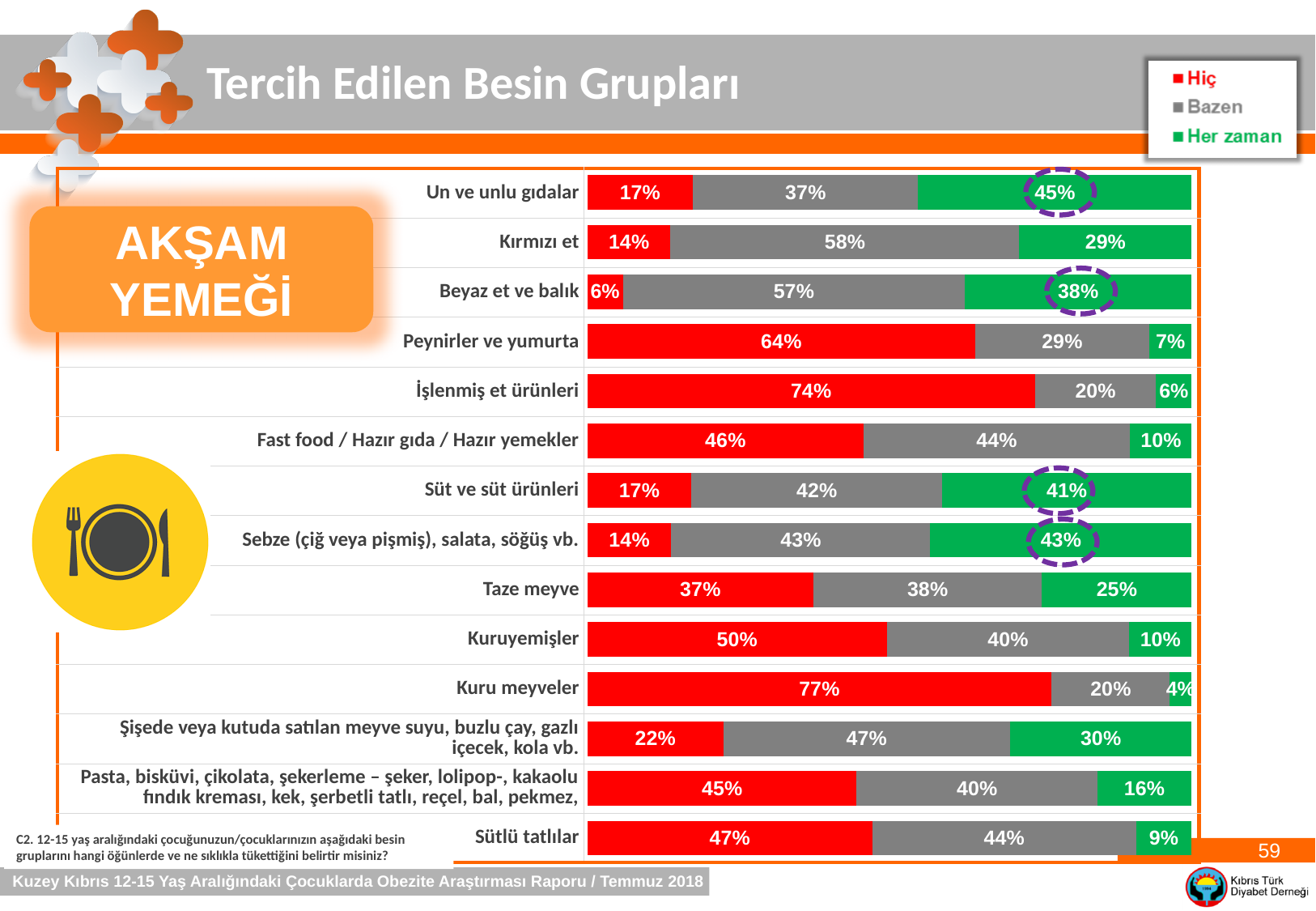
Which food group has the highest "Her zaman" value? Un ve unlu gıdalar What is the difference between the "Hiç" values for Kuru meyveler and Taze meyve? 40% How many series does the legend list? 3 What kind of chart is shown on the slide? Stacked bar chart How many food groups are shown in the chart? 14 What is the "Bazen" value for Kırmızı et? 58% What is the "Hiç" value for İşlenmiş et ürünleri? 74% What is the "Her zaman" value for Sütlü tatlılar? 9% Which food group has the highest "Hiç" value? Kuru meyveler What percentage of respondents answered "Her zaman" for Un ve unlu gıdalar? 45% Which food group has the lowest "Hiç" value? Beyaz et ve balık Which is larger: the "Her zaman" value for Süt ve süt ürünleri or for Taze meyve? Süt ve süt ürünleri